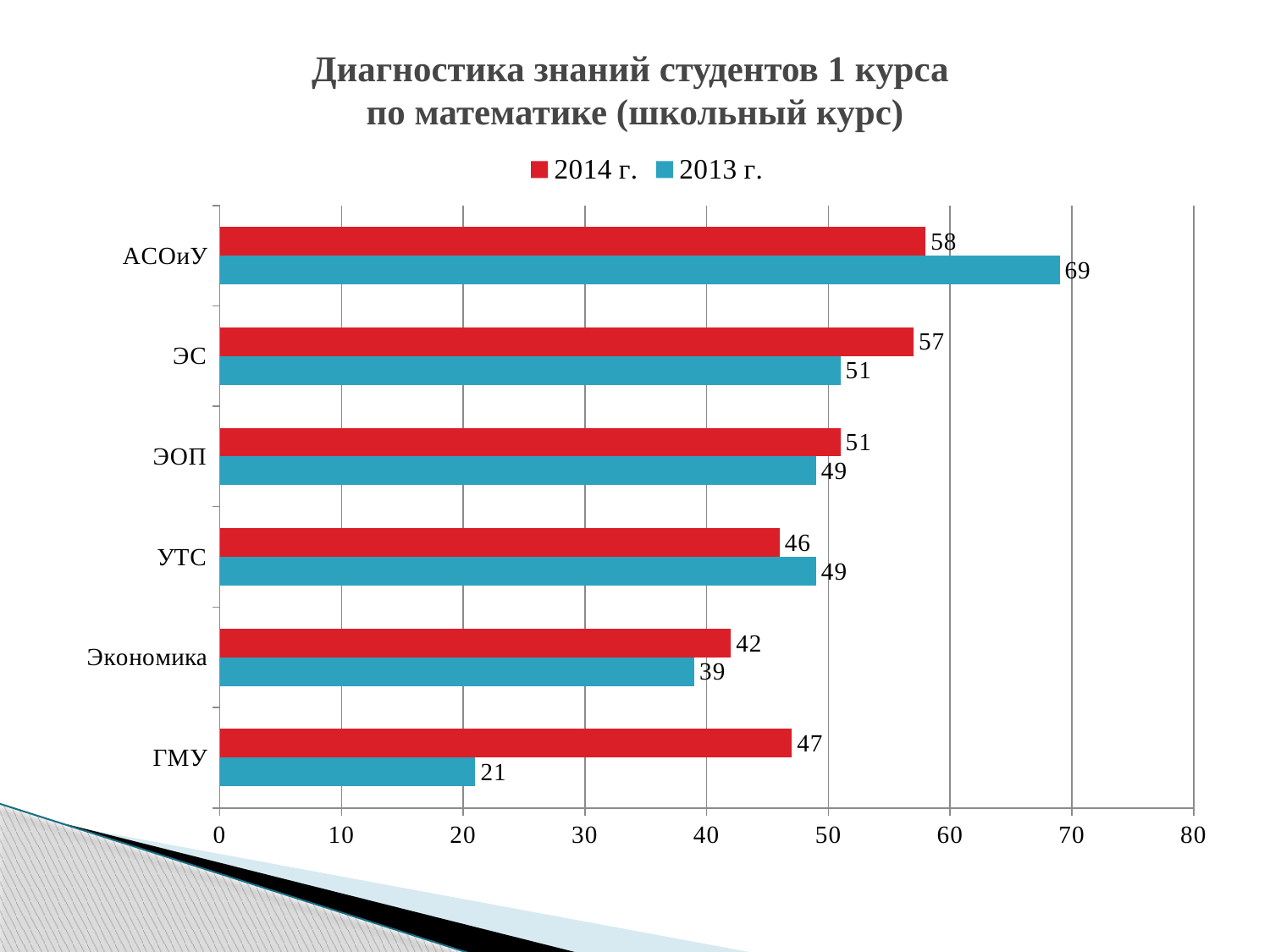
How many categories are shown on the chart? 6 Which is larger for ЭС: the 2014 г. value or the 2013 г. value? 2014 г. What kind of chart is shown on the slide? bar chart Which category has the lowest value in the 2013 г. series? ГМУ Which category has the highest value in the 2014 г. series? АСОиУ What is the value for ГМУ in the 2014 г. series? 47 What is the value for Экономика in the 2013 г. series? 39 What is the difference between the 2013 г. and 2014 г. values for АСОиУ? 11 How many series does the legend list? 2 What is the value for АСОиУ in the 2013 г. series? 69 What is the difference between the 2013 г. and 2014 г. values for ГМУ? 26 What colour represents the 2013 г. series? blue